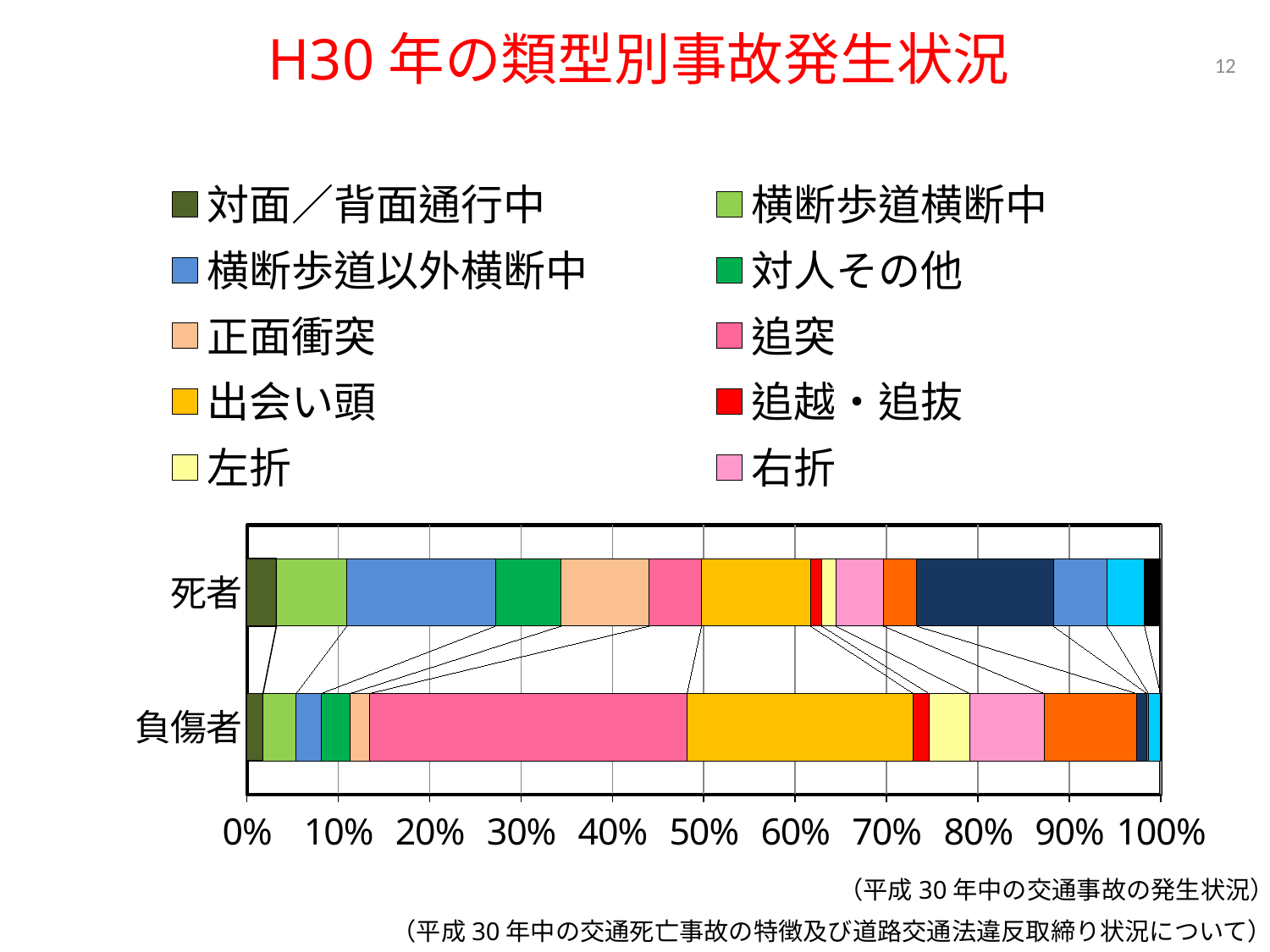
Which bar has the larger share for 追突, 死者 or 負傷者? 負傷者 What are the two categories shown on the vertical axis? 死者 and 負傷者 How many categories (bars) does the chart show? 2 Which bar has the larger share for 横断歩道以外横断中, 死者 or 負傷者? 死者 Which series takes the largest share of the 負傷者 bar? 追突 What kind of chart is shown on the slide? stacked bar chart Which bar has the larger share for 対面／背面通行中, 死者 or 負傷者? 死者 What is the title of the chart on the slide? H30年の類型別事故発生状況 How many series does the legend list? 10 Is the share of 出会い頭 in the 負傷者 bar greater or less than 10%? greater Is the share of 追突 in the 負傷者 bar greater or less than 20%? greater Is the share of 追越・追抜 in the 死者 bar greater or less than 10%? less